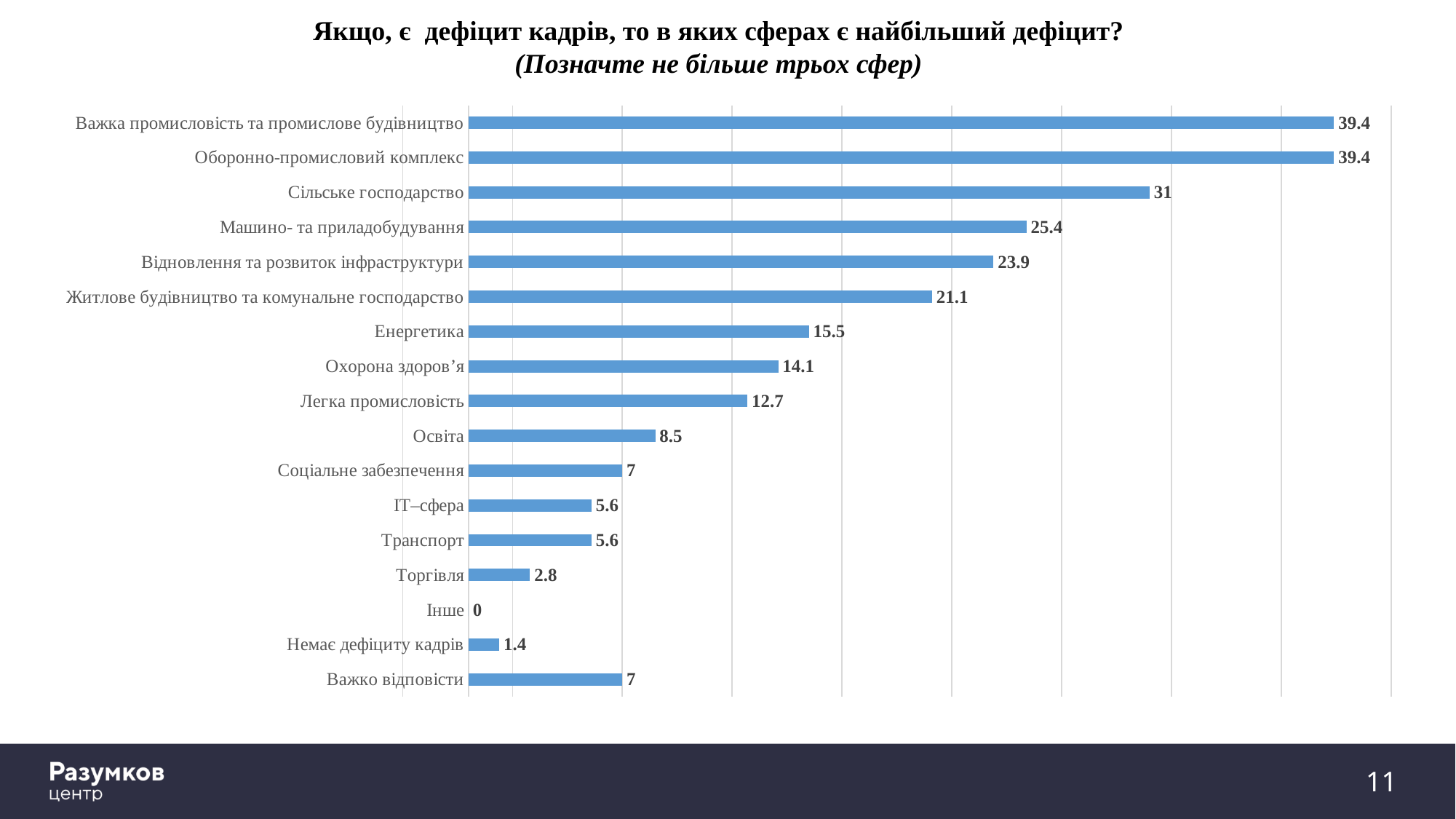
What kind of chart is shown on the slide? Bar chart What is the difference between the values for Машино- та приладобудування and Відновлення та розвиток інфраструктури? 1.5 Which is larger, the value for Освіта or the value for Легка промисловість? Легка промисловість What is the difference between the values for Сільське господарство and Житлове будівництво та комунальне господарство? 9.9 What is the highest value shown on the chart? 39.4 What is the value for Енергетика? 15.5 What is the total of the values for ІТ–сфера and Транспорт? 11.2 Which category has the lowest value? Інше What is the value for Немає дефіциту кадрів? 1.4 What is the value for Сільське господарство? 31 What is the value for Охорона здоров’я? 14.1 How many categories are shown on the chart? 17